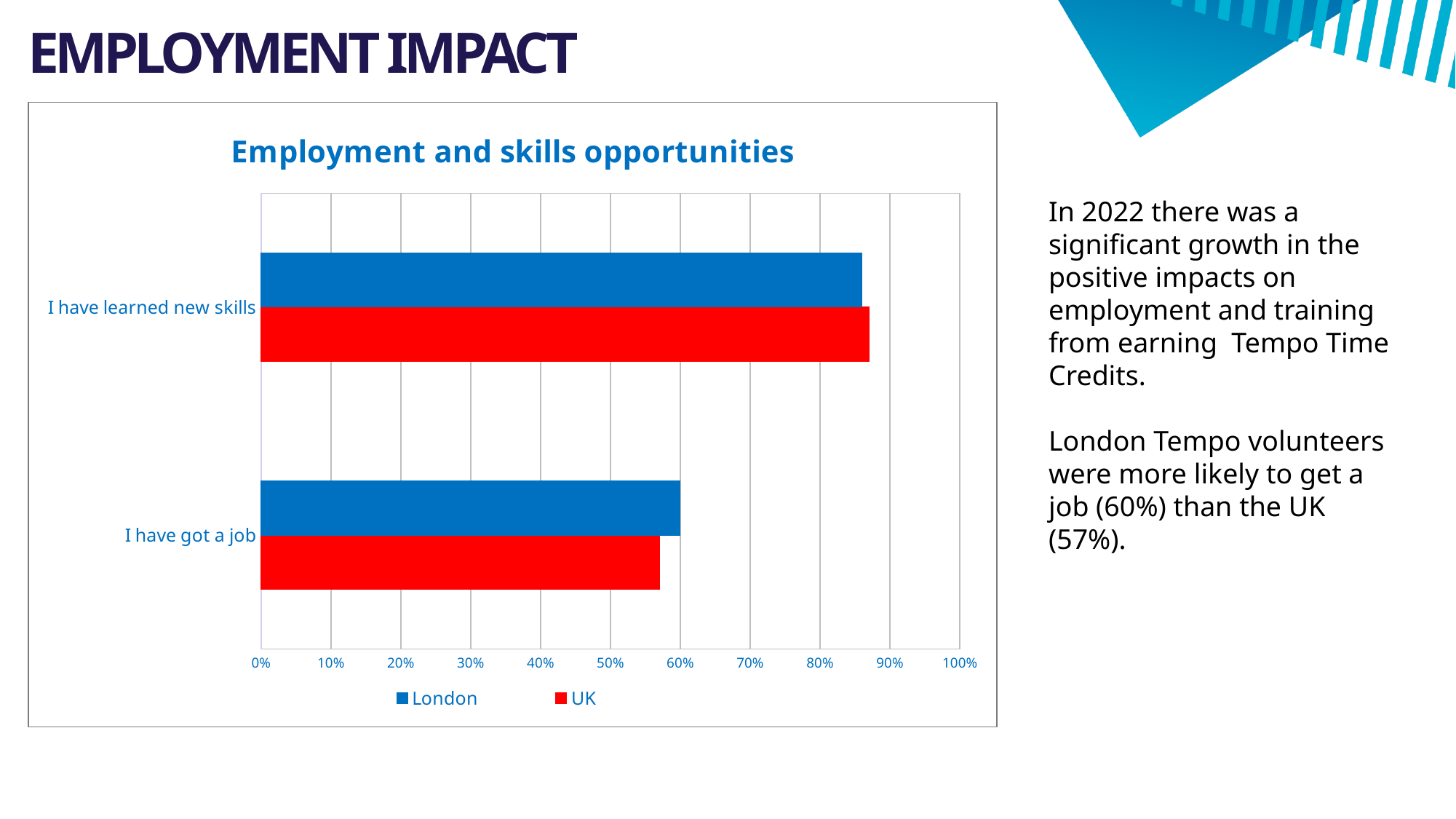
How many categories are shown on the chart's vertical axis? 2 How many series does the chart legend list? 2 For "I have got a job", which is larger, the London value or the UK value? London Which colour represents the UK series in the chart? Red Is the London value for "I have learned new skills" greater or less than 80%? greater What kind of chart is shown on the slide? Bar chart What is the London value for "I have got a job"? 60% What is the difference between the London and UK values for "I have got a job"? 3% What is the UK value for "I have got a job"? 57% Is the UK value for "I have learned new skills" greater or less than 90%? less Which category has the higher values for both London and the UK? I have learned new skills What is the title of the chart? Employment and skills opportunities